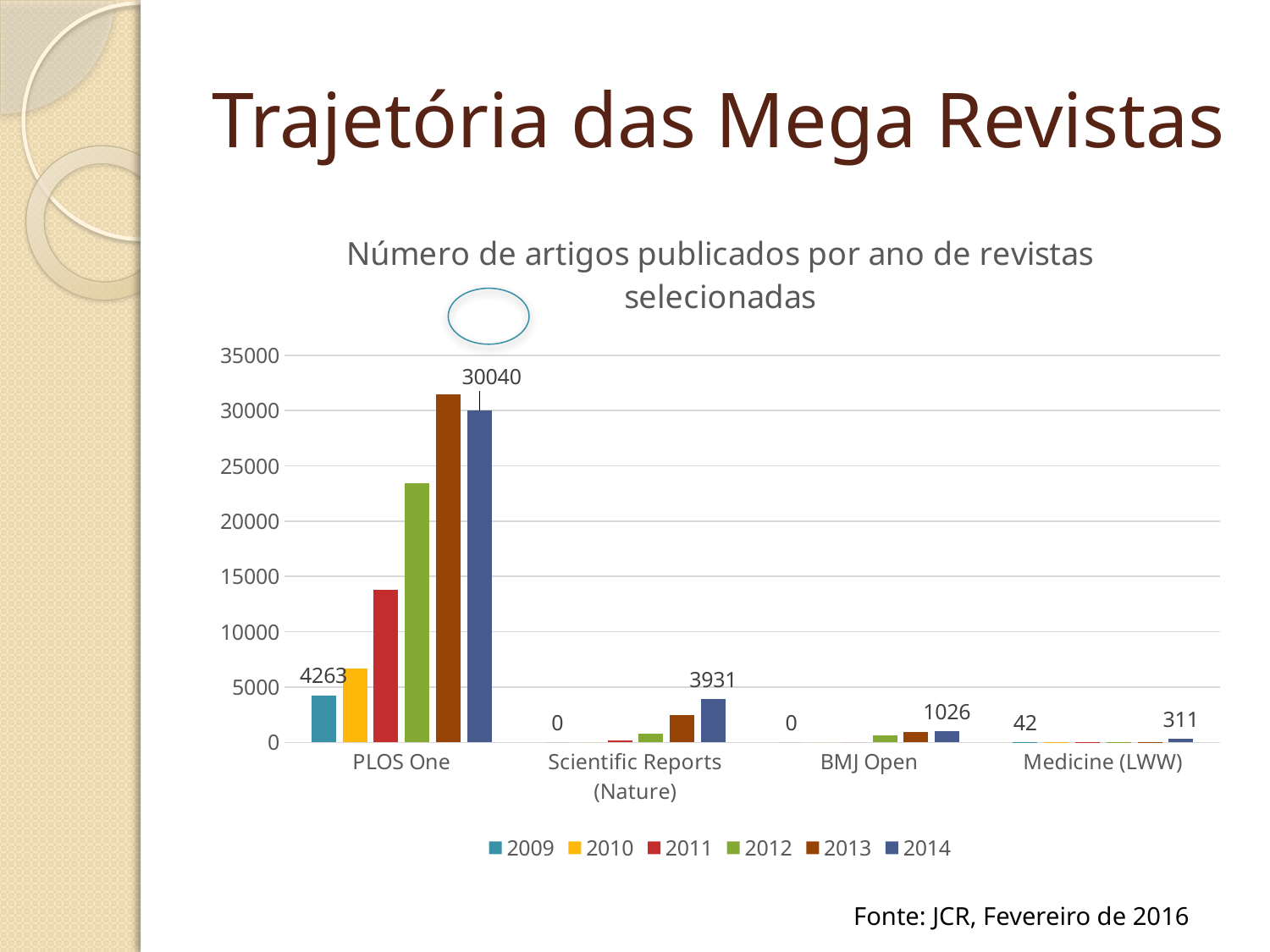
Is the value for PLOS One in 2013 greater or less than 30000? greater What is the title of the chart? Número de artigos publicados por ano de revistas selecionadas How many series does the legend list? 6 What type of chart is shown on the slide? bar chart Which journal has the highest value in 2014? PLOS One What is the value for PLOS One in 2014? 30040 What is the difference between the 2014 and 2009 values for PLOS One? 25777 What is the value for Medicine (LWW) in 2009? 42 What is the value for PLOS One in 2009? 4263 Which is larger, the 2014 value for BMJ Open or the 2014 value for Medicine (LWW)? BMJ Open What is the value for Scientific Reports (Nature) in 2014? 3931 How many journal categories are shown on the x axis? 4